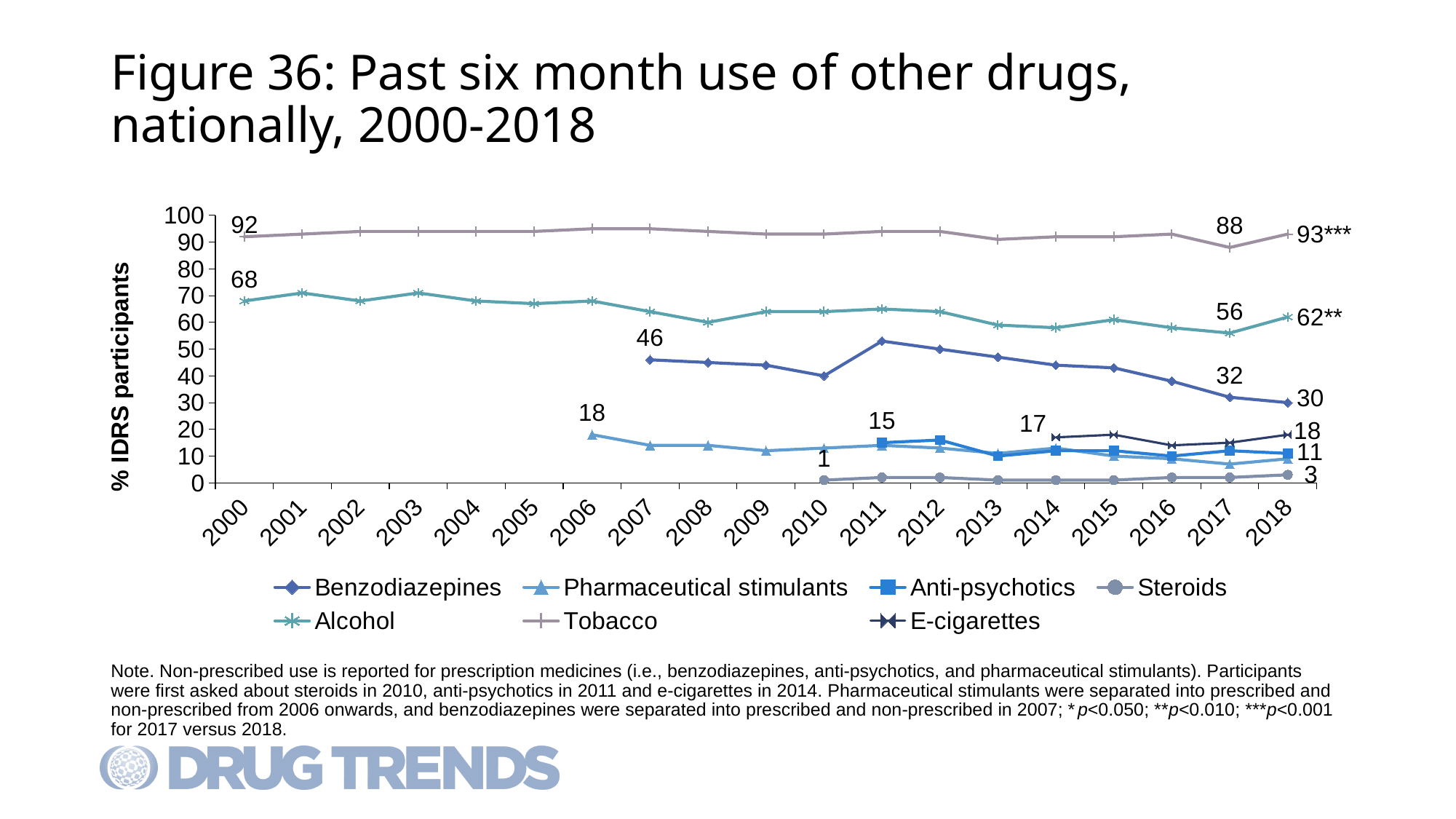
By how many percentage points did tobacco use fall from 2000 to 2017? 4 Which series has the highest value in 2018? Tobacco Is the alcohol value for 2008 greater or less than 70? less What was the value for steroids in 2010? 1 How many series does the legend list? 7 Which year had the higher alcohol value, 2000 or 2017? 2000 What is the difference between the benzodiazepines values for 2017 and 2018? 2 What was the value for e-cigarettes in 2014? 17 What was the percentage of IDRS participants reporting alcohol use in 2000? 68 What kind of chart is shown on the slide? line chart What was the value for benzodiazepines in 2007? 46 What was the percentage of IDRS participants reporting tobacco use in 2000? 92